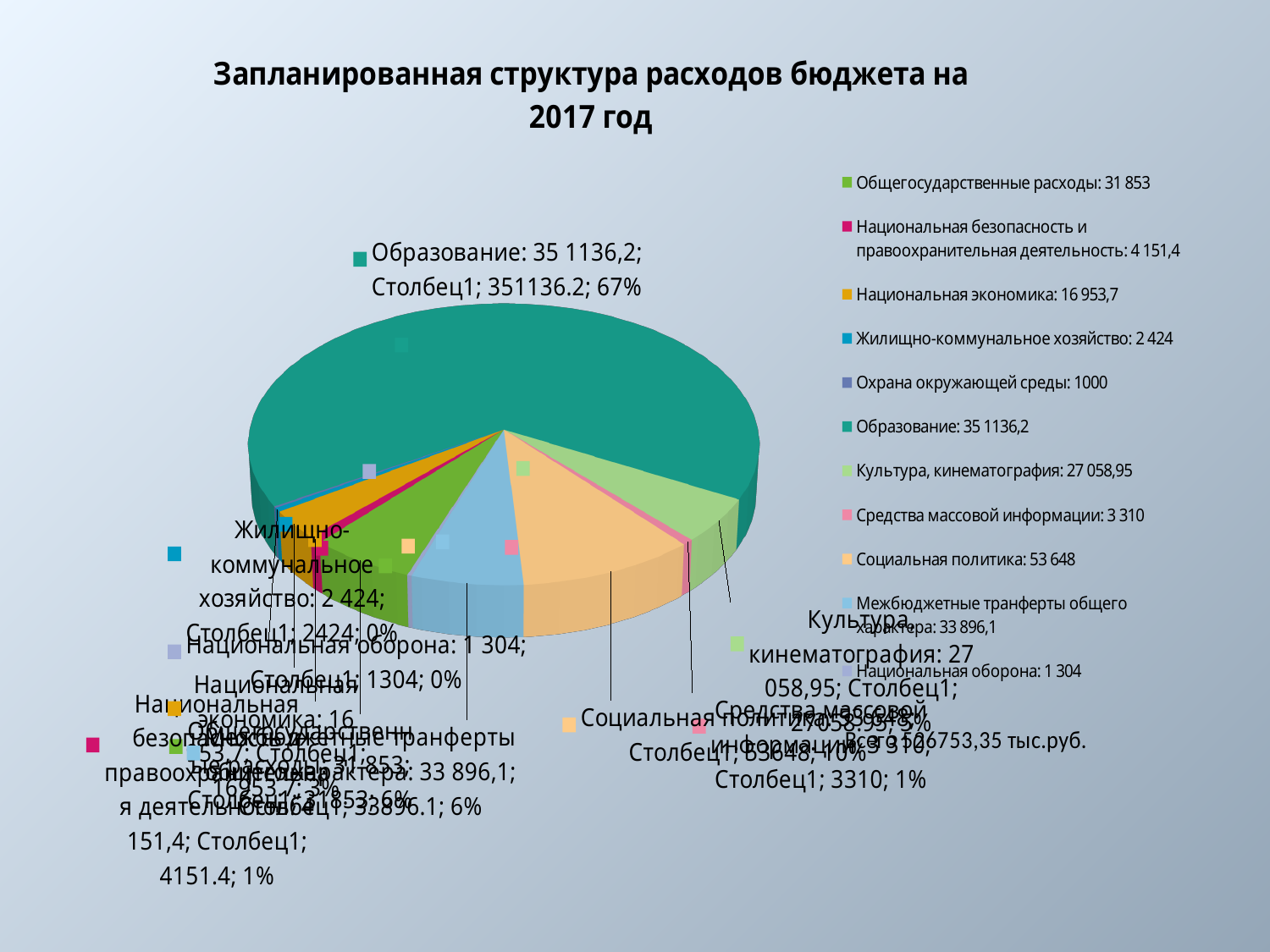
What is the value for Культура, кинематография in the legend? 27 058,95 What percentage share does Средства массовой информации have in the pie chart? 1% Which category has the smallest value in the legend? Охрана окружающей среды What is the value for Социальная политика in the legend? 53 648 What kind of chart is shown on the slide? pie chart What percentage share does Образование have in the pie chart? 67% What is the value for Охрана окружающей среды in the legend? 1000 How many categories does the legend list? 11 What is the title of the chart? Запланированная структура расходов бюджета на 2017 год Which is larger, Социальная политика or Общегосударственные расходы? Социальная политика Which category has the largest slice of the pie? Образование What percentage share does Социальная политика have in the pie chart? 10%